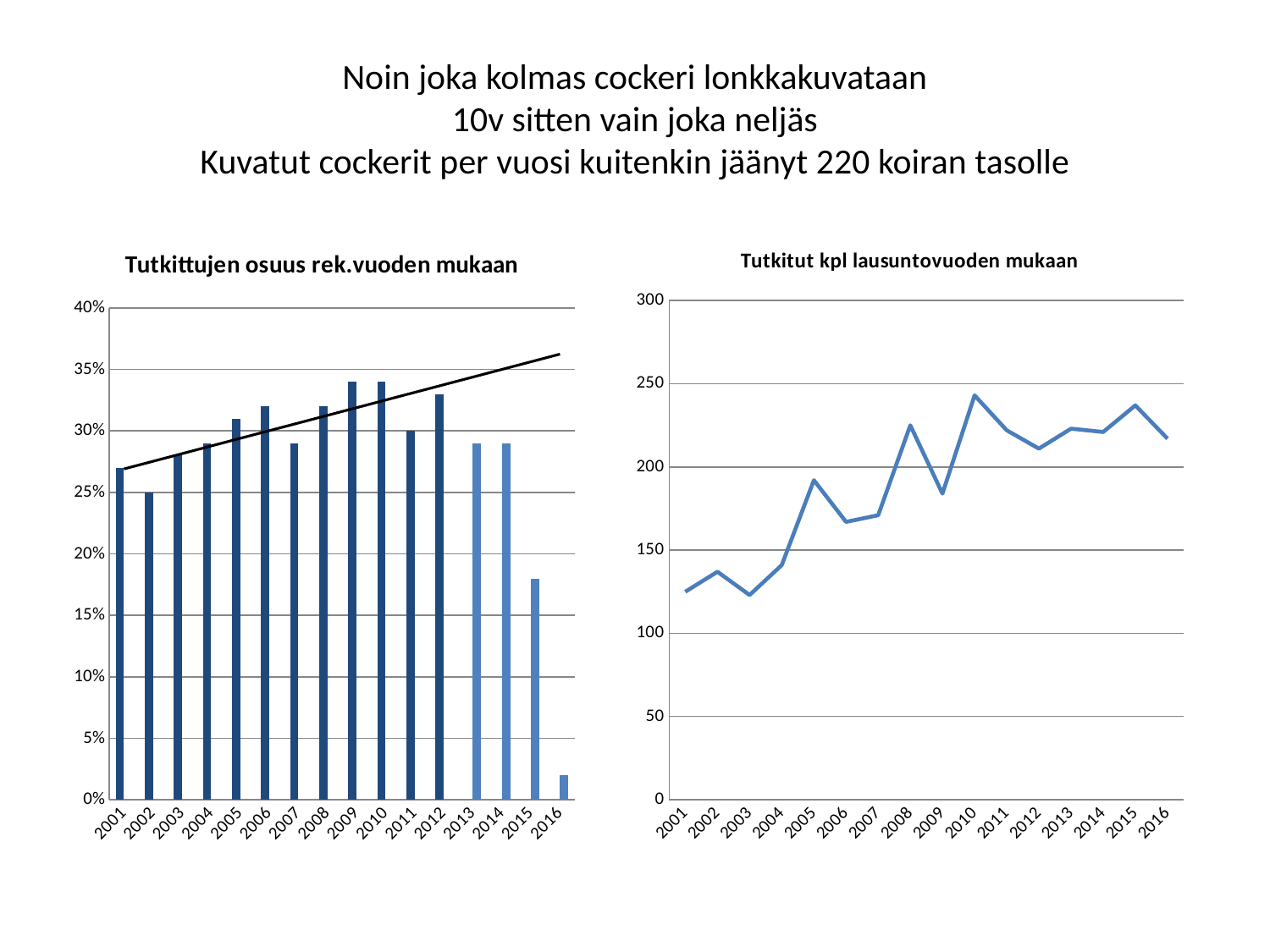
In the left chart "Tutkittujen osuus rek.vuoden mukaan", is the value for 2009 greater or less than 30%? greater What kind of chart is the left chart titled "Tutkittujen osuus rek.vuoden mukaan"? bar chart In the right chart "Tutkitut kpl lausuntovuoden mukaan", which year has the highest value? 2010 In the right chart "Tutkitut kpl lausuntovuoden mukaan", which year has the larger value, 2005 or 2006? 2005 In the left chart "Tutkittujen osuus rek.vuoden mukaan", which year has the lowest bar? 2016 In the right chart "Tutkitut kpl lausuntovuoden mukaan", is the value for 2010 greater or less than 200? greater In the right chart "Tutkitut kpl lausuntovuoden mukaan", how many years are plotted? 16 In the left chart "Tutkittujen osuus rek.vuoden mukaan", how many years are shown on the x axis? 16 What kind of chart is the right chart titled "Tutkitut kpl lausuntovuoden mukaan"? line chart In the right chart "Tutkitut kpl lausuntovuoden mukaan", do the values overall rise or fall from 2001 to 2016? rise In the left chart "Tutkittujen osuus rek.vuoden mukaan", is the value for 2015 greater or less than 20%? less